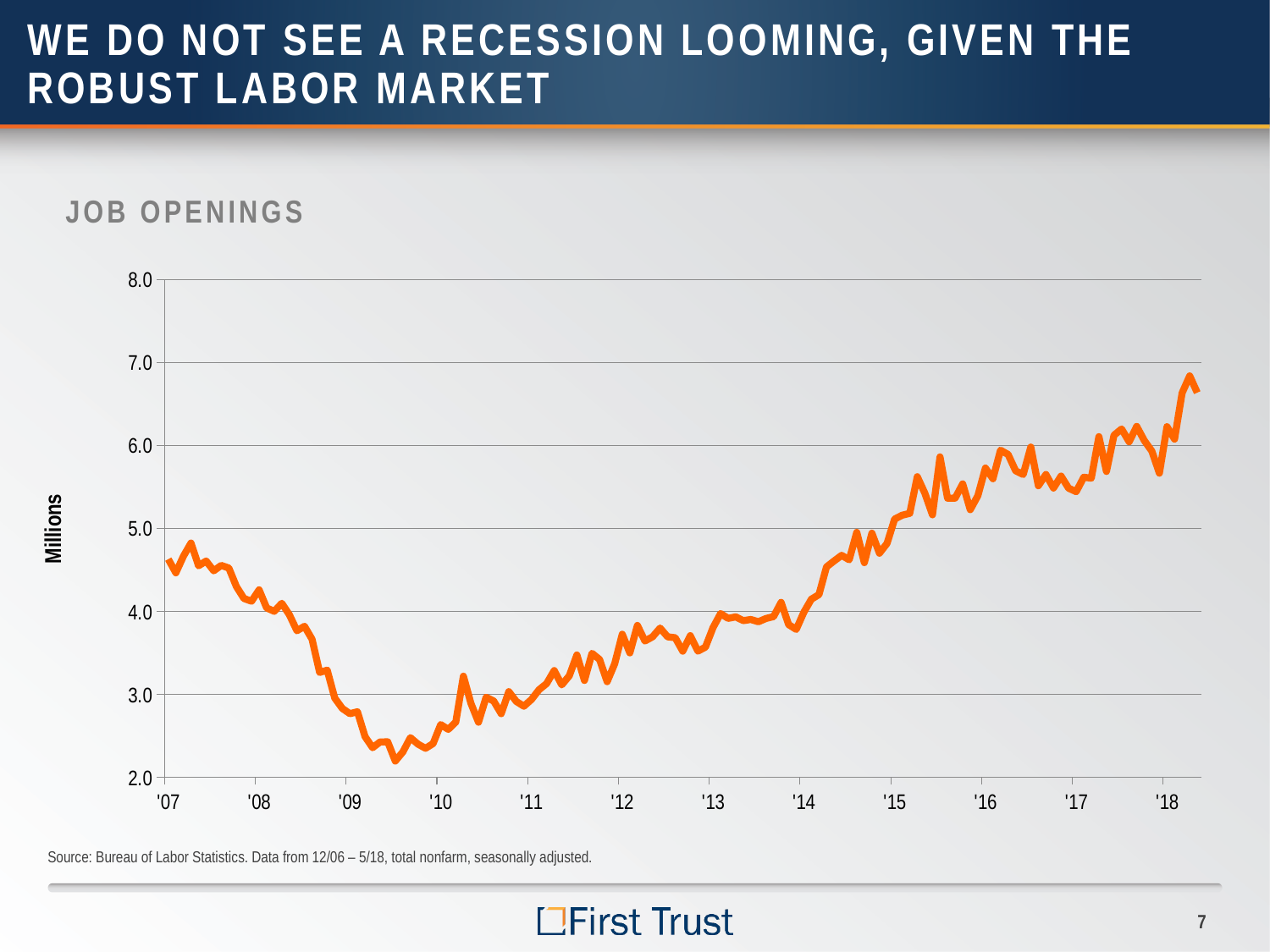
Is the value for job openings at the start of '10 greater or less than 3.0? less What kind of chart is shown on the slide? line chart Do job openings rise or fall between '10 and '18? rise Do job openings rise or fall between '07 and '09? fall How many year labels are shown along the x axis of the chart? 12 Is the highest point on the line greater or less than 7.0? less Around which year label does the line reach its lowest point? '09 What unit is shown on the vertical axis label of the chart? Millions Is the value for job openings at the start of '12 greater or less than 4.0? less What is the title of the chart? JOB OPENINGS